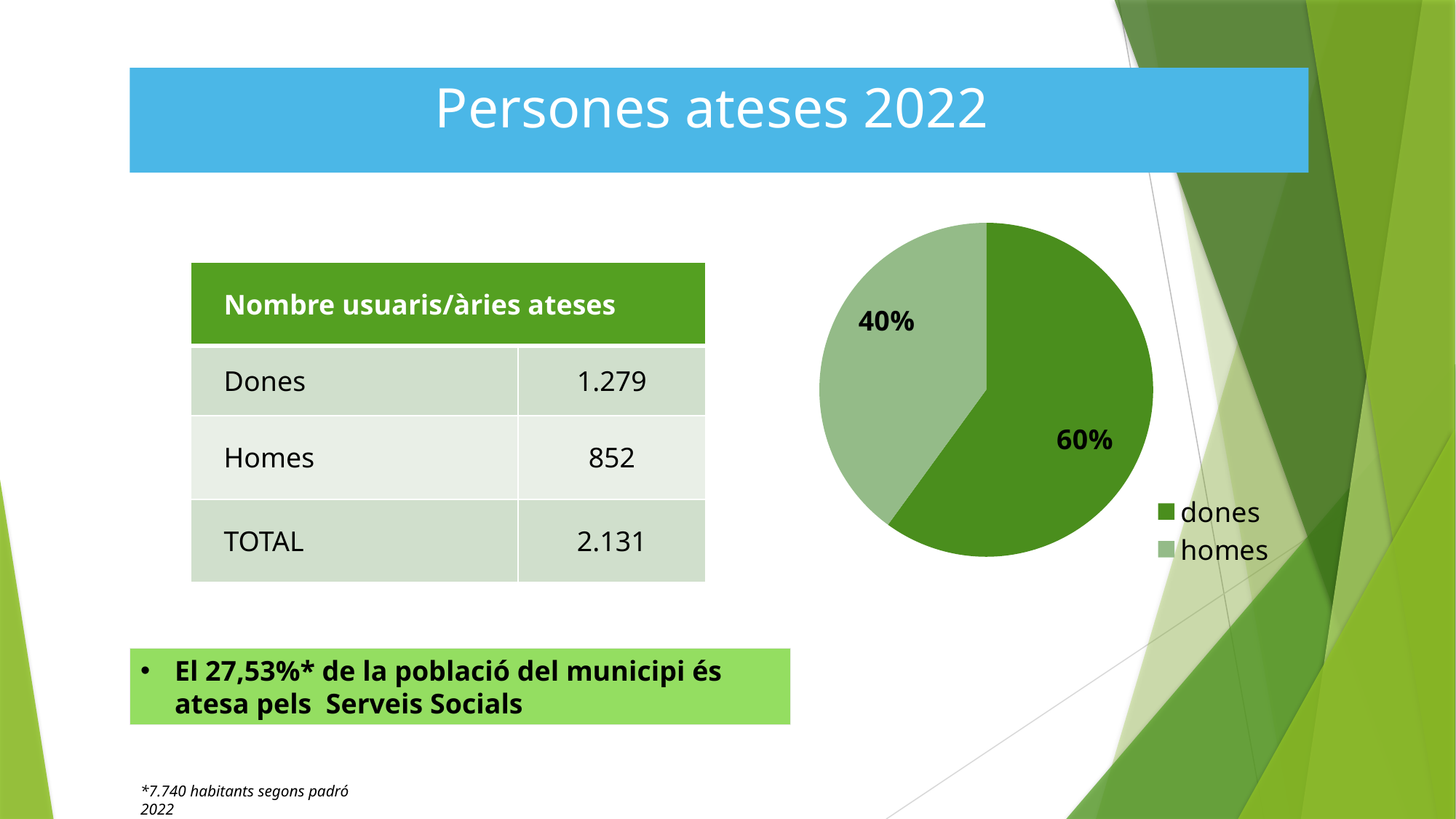
What share of the pie chart does the "homes" slice represent? 40% Which slice is larger in the pie chart, dones or homes? dones Which legend entry of the pie chart is shown in the darker green colour? dones Is the share of the homes slice in the pie chart greater or less than 50%? less What share of the pie chart does the "dones" slice represent? 60% What is the difference in percentage points between the dones and homes slices of the pie chart? 20% Which slice of the pie chart is the smallest? homes How many slices does the pie chart have? 2 How many entries does the pie chart's legend list? 2 Which slice of the pie chart is the largest? dones What kind of chart is shown on the slide? pie chart